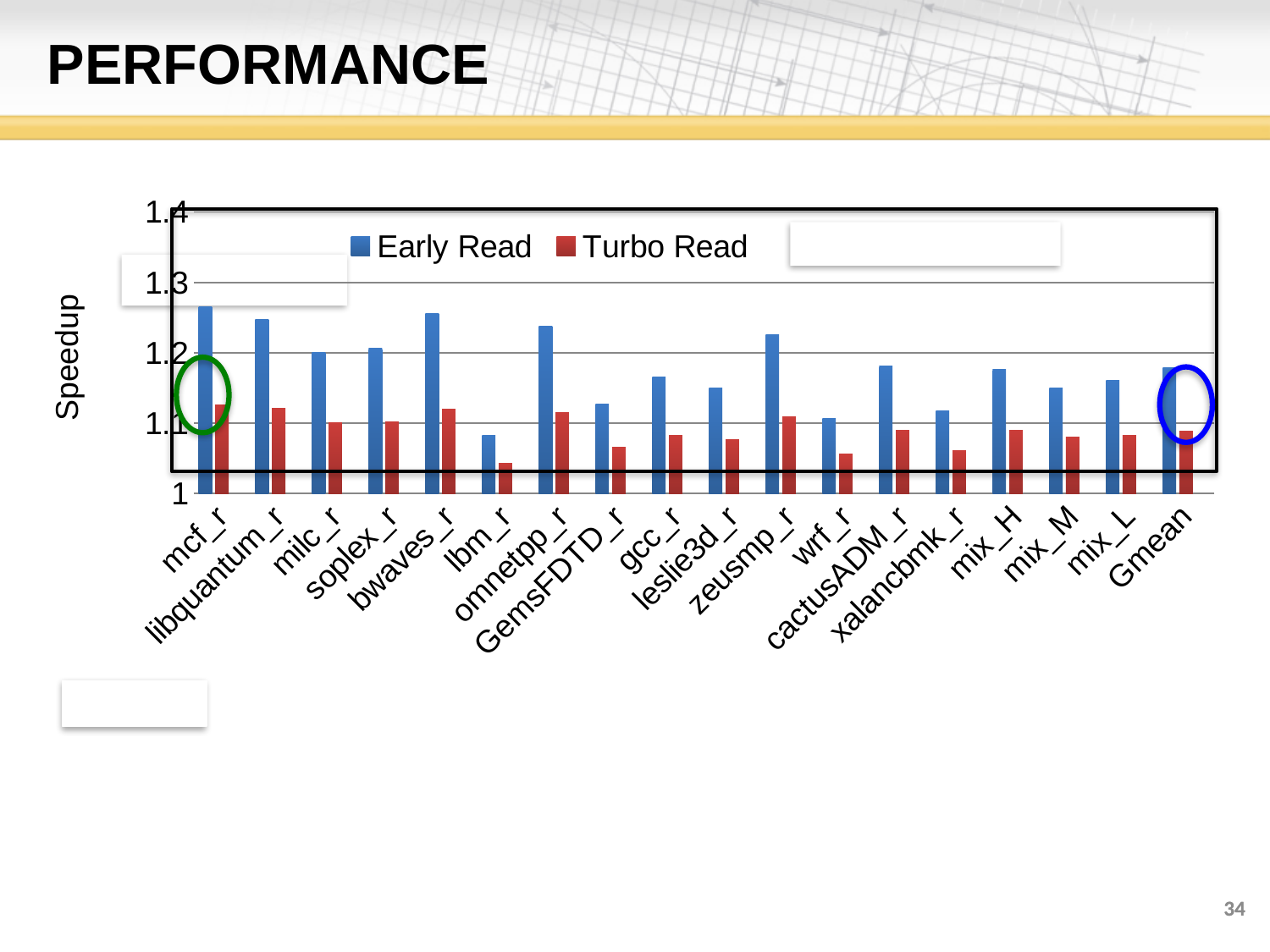
What is the label on the vertical axis? Speedup Is the Early Read value for lbm_r greater or less than 1.1? less Which has the larger Early Read value: libquantum_r or milc_r? libquantum_r How many categories are shown along the x axis? 18 How many series does the legend list? 2 Is the Turbo Read value for wrf_r greater or less than 1.1? less What kind of chart is shown on the slide? bar chart Which category has the lowest Turbo Read speedup? lbm_r For mcf_r, which is larger: the Early Read value or the Turbo Read value? Early Read Is the Early Read value for mcf_r greater or less than 1.2? greater Which category has the lowest Early Read speedup? lbm_r What are the two series named in the legend? Early Read and Turbo Read